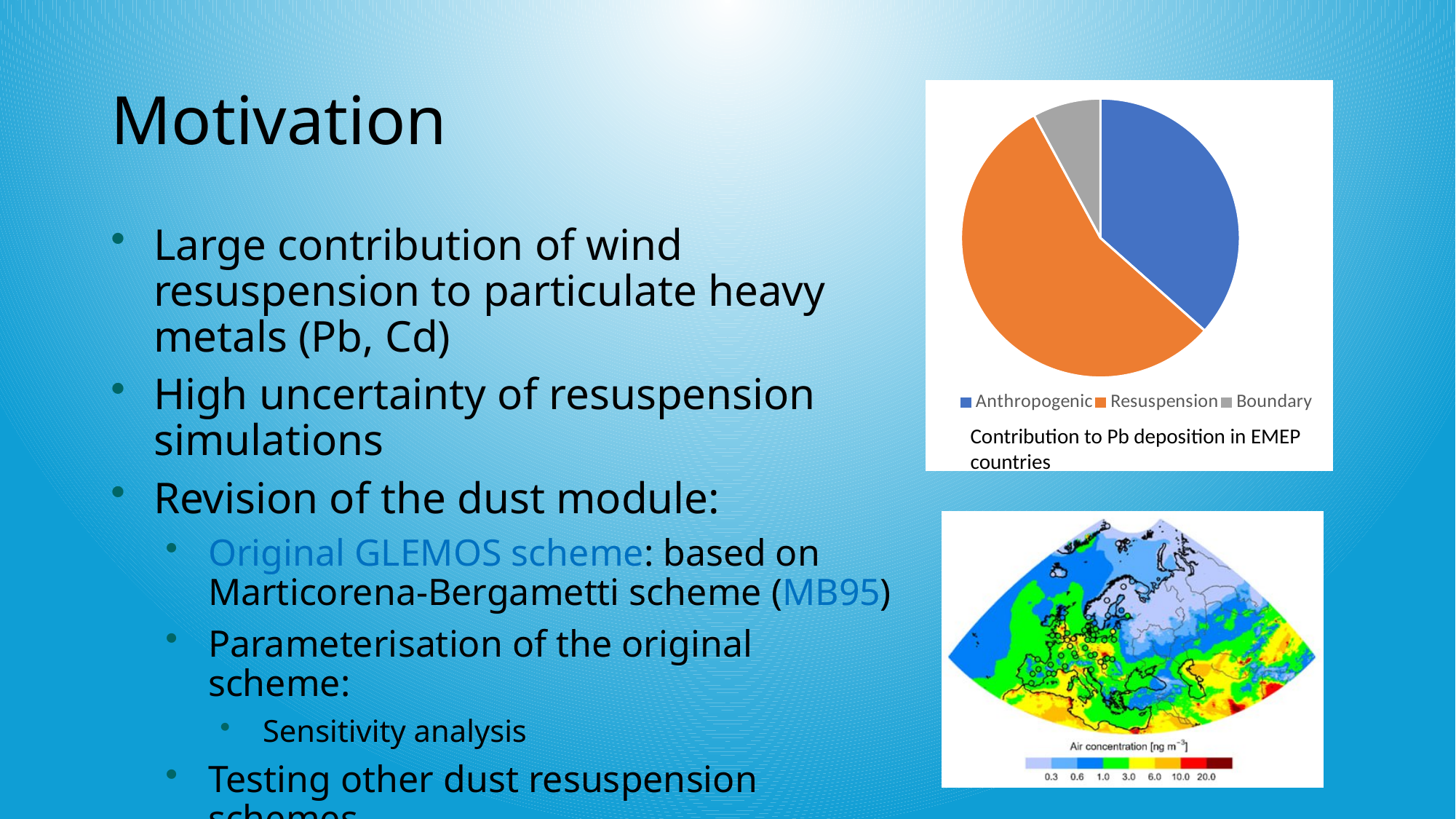
How many slices does the pie chart have? 3 What does the caption below the pie chart say the chart shows? Contribution to Pb deposition in EMEP countries In the pie chart, which is larger: the Boundary slice or the Resuspension slice? Resuspension How many entries does the legend of the pie chart list? 3 In the pie chart, which is larger: the Anthropogenic slice or the Resuspension slice? Resuspension Which category has the smallest slice in the pie chart? Boundary What kind of chart is shown in the top right of the slide? pie chart In the pie chart, which is larger: the Anthropogenic slice or the Boundary slice? Anthropogenic What colour is the Resuspension slice in the pie chart? orange Which category has the largest slice in the pie chart? Resuspension